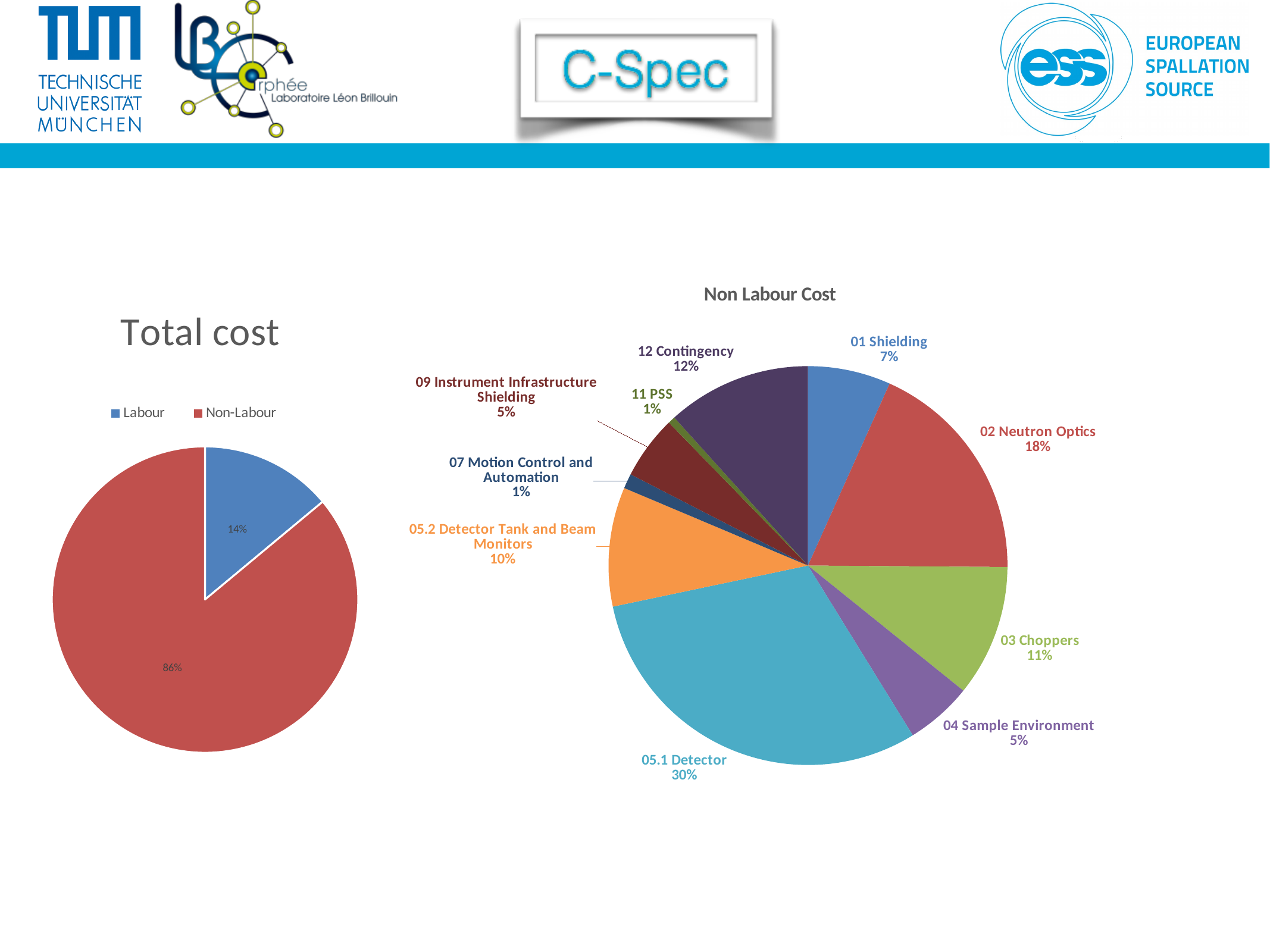
In the Total cost chart, which category has the larger share, Labour or Non-Labour? Non-Labour In the Non Labour Cost chart, how many categories are shown? 10 In the Non Labour Cost chart, which category has the largest share? 05.1 Detector In the Non Labour Cost chart, what share does 02 Neutron Optics have? 18% In the Non Labour Cost chart, what is the difference in share between 12 Contingency and 03 Choppers? 1% In the Total cost chart, what share does Labour have? 14% What is the title of the pie chart on the right side of the slide? Non Labour Cost What kind of chart is the Total cost chart? Pie chart How many entries does the legend of the Total cost chart list? 2 In the Non Labour Cost chart, which has the larger share, 01 Shielding or 05.2 Detector Tank and Beam Monitors? 05.2 Detector Tank and Beam Monitors In the Non Labour Cost chart, what share does 05.1 Detector have? 30%